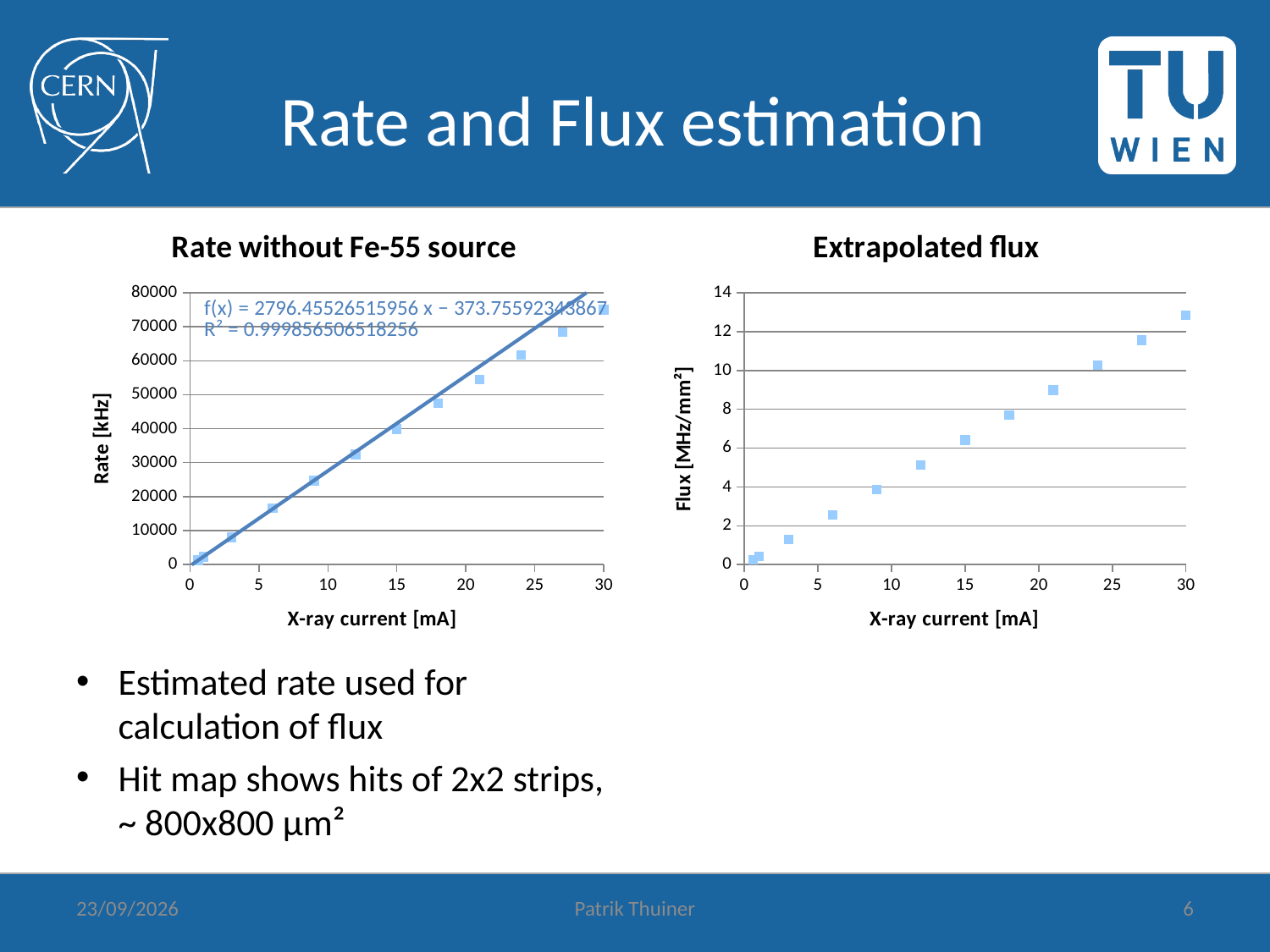
What kind of chart is the 'Rate without Fe-55 source' chart? scatter chart In the 'Rate without Fe-55 source' chart, is the rate at 30 mA greater or less than 70000? greater In the 'Extrapolated flux' chart, do the flux values rise or fall as the X-ray current increases? rise What is the y-axis label of the 'Extrapolated flux' chart? Flux [MHz/mm²] In the 'Rate without Fe-55 source' chart, do the rate values rise or fall as the X-ray current increases? rise In the 'Extrapolated flux' chart, is the flux at 21 mA greater or less than 8? greater In the 'Extrapolated flux' chart, is the flux at 3 mA greater or less than 2? less In the 'Extrapolated flux' chart, which X-ray current has the highest flux? 30 What R² value is shown for the trendline in the 'Rate without Fe-55 source' chart? 0.999856506518256